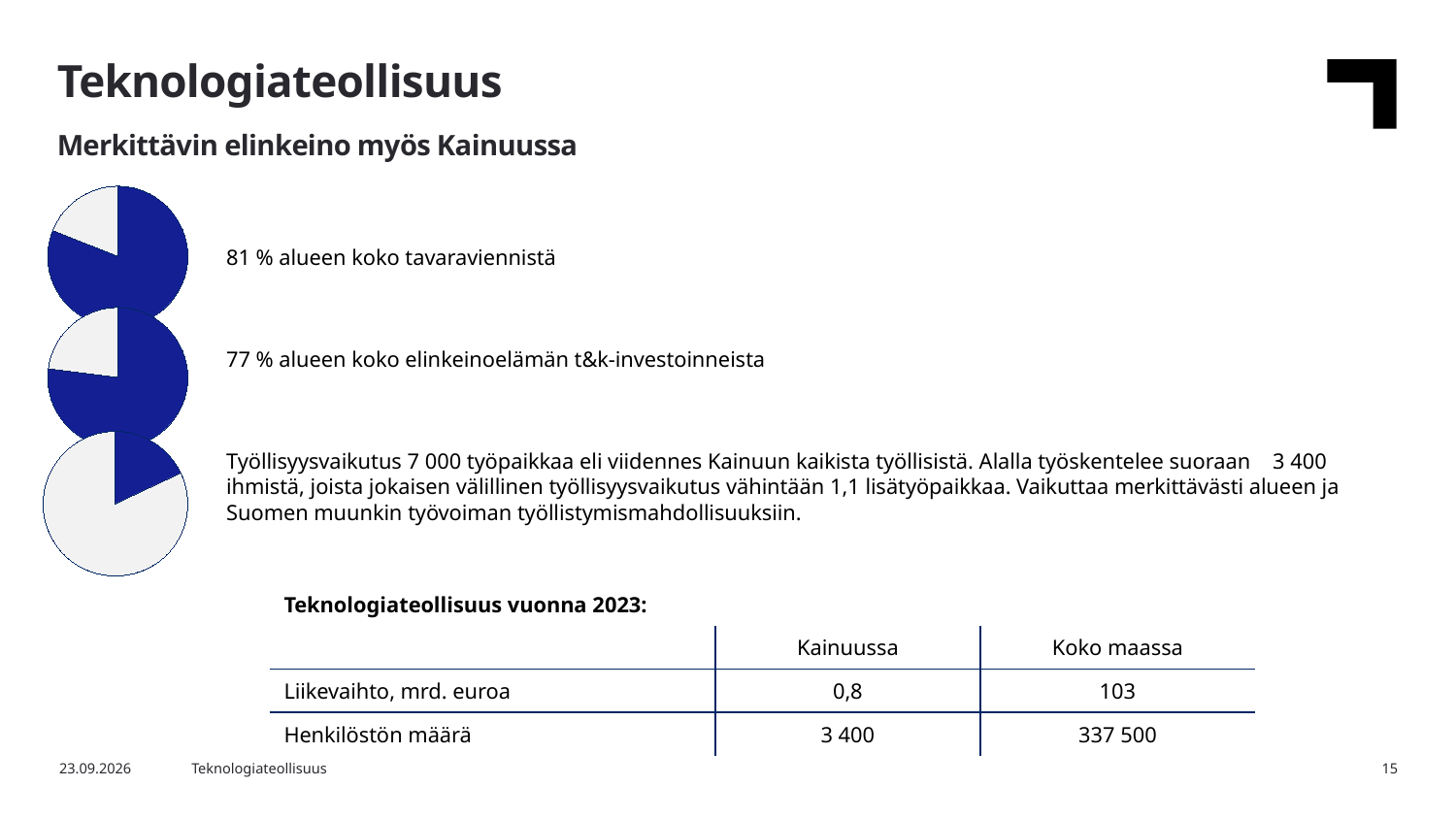
How many pie charts are shown on the slide? 3 In the bottom pie chart (employment effect), is the blue slice greater or less than half of the pie? less What is the difference in percentage points between the share shown in the top pie chart (81 %) and the middle pie chart (77 %)? 4 percentage points Which of the three pie charts has the smallest blue slice? The bottom one (employment effect) Which is larger: the technology industry's share of goods exports (top pie) or its share of R&D investments (middle pie)? Share of goods exports (81 %) According to the middle pie chart, what share of the region's business R&D investments (t&k-investoinneista) does the technology industry account for? 77 % What colour is used for the technology industry's slice in the pie charts? Dark blue How many slices does each pie chart have? 2 What kind of charts are the three charts on the left side of the slide? Pie charts According to the top pie chart, what share of the region's total goods exports (tavaraviennistä) does the technology industry account for? 81 % In the top pie chart, what share of the pie is the grey (non-technology-industry) slice? 19 % Which of the three pie charts has the largest blue slice? The top one (81 % of goods exports)